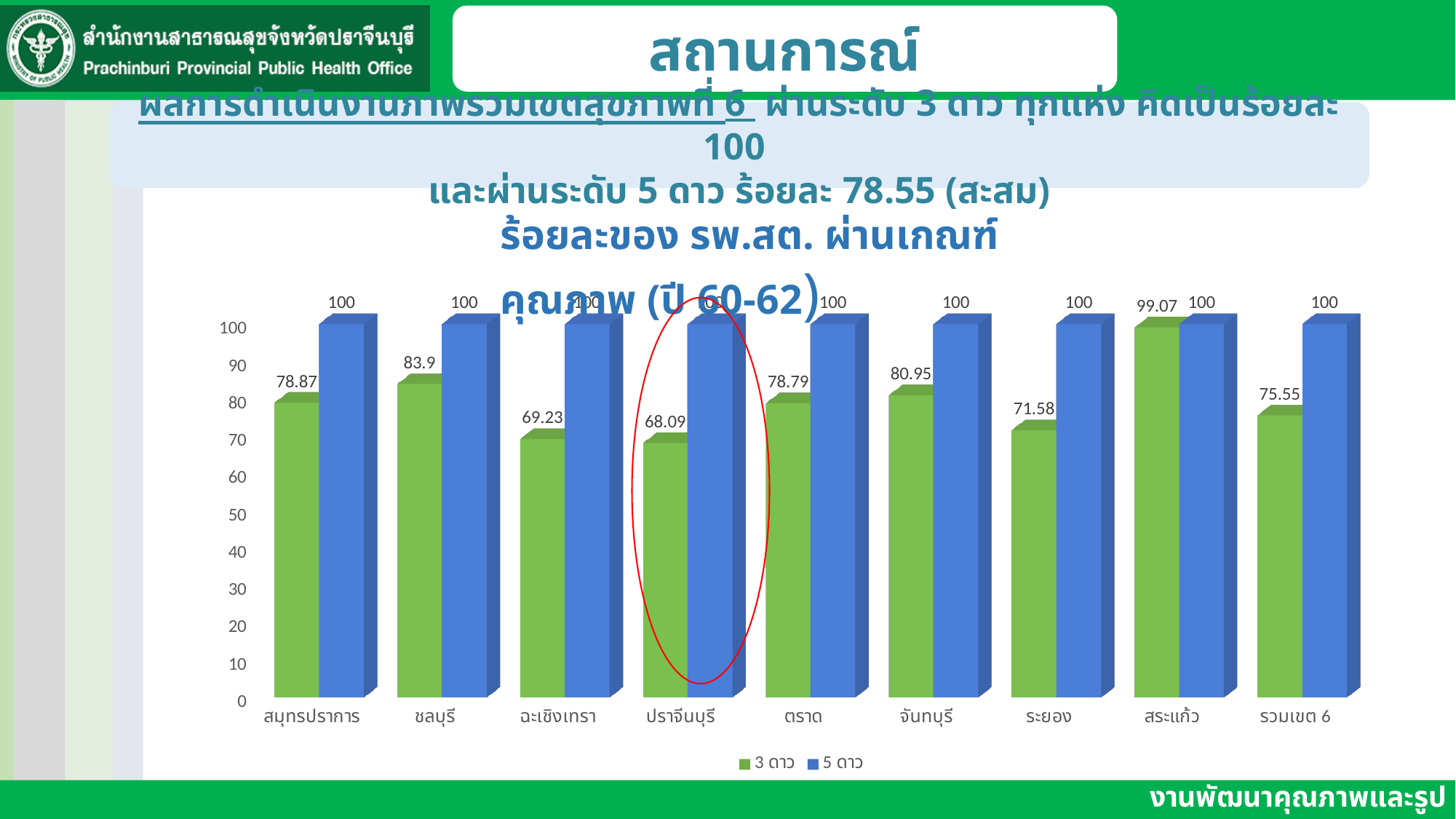
Which has the larger green "3 ดาว" value, จันทบุรี or ตราด? จันทบุรี What is the value of the blue "5 ดาว" bar for ชลบุรี? 100 How many categories are shown on the x axis of the chart? 9 Which category on the chart is circled in red? ปราจีนบุรี What is the value of the green "3 ดาว" bar for รวมเขต 6? 75.55 How many series does the chart legend list? 2 What kind of chart is shown on the slide? bar chart What is the value of the green "3 ดาว" bar for สมุทรปราการ? 78.87 Which category has the lowest green "3 ดาว" bar? ปราจีนบุรี Is the green "3 ดาว" value for ปราจีนบุรี greater or less than 70? less Which category has the highest green "3 ดาว" bar? สระแก้ว What is the difference between the green "3 ดาว" values for ชลบุรี and ฉะเชิงเทรา? 14.67